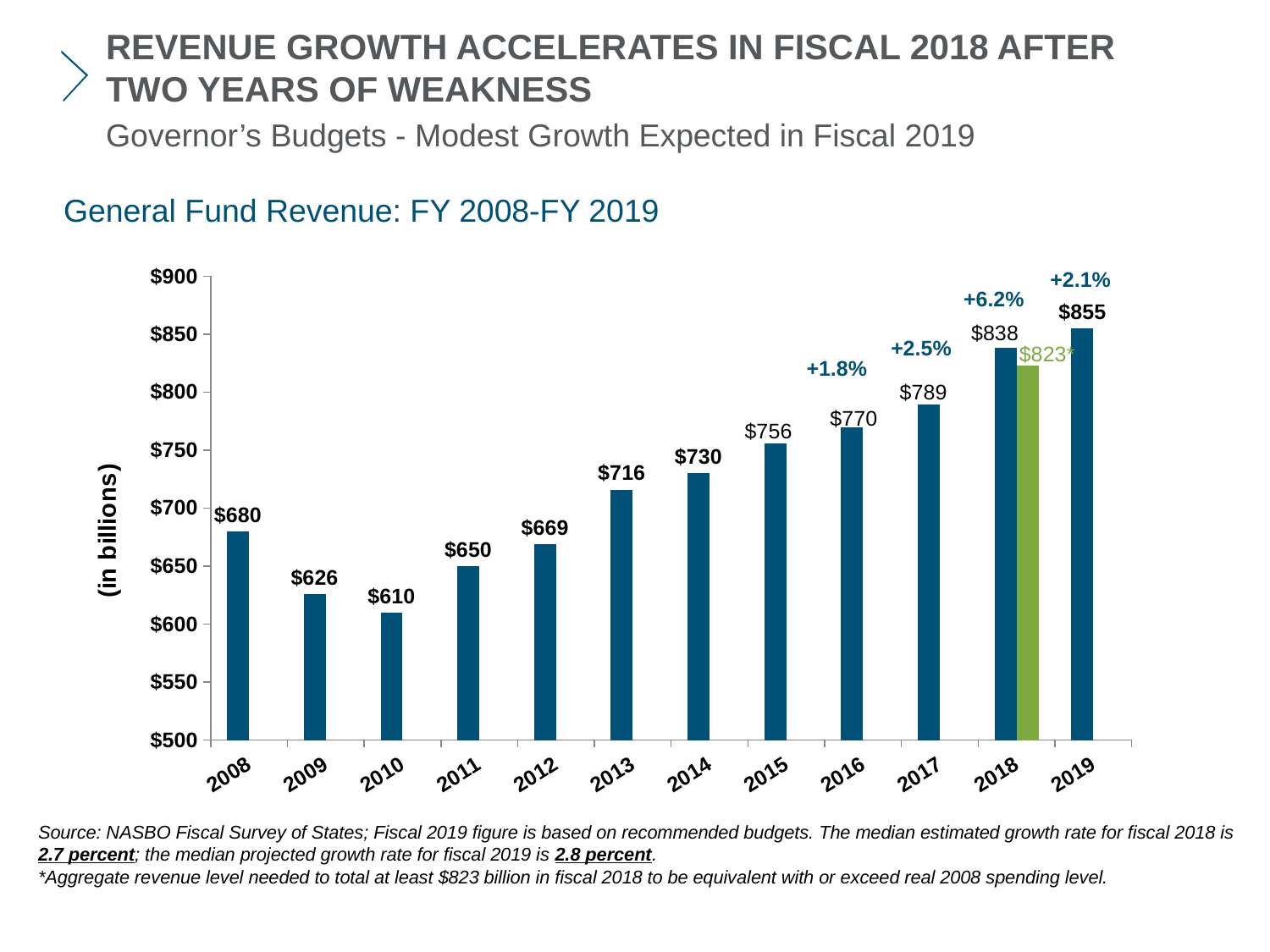
What unit is shown on the y axis label of the chart? in billions What is the General Fund Revenue value for 2013? $716 What kind of chart is used to show General Fund Revenue? Bar chart Do the General Fund Revenue values rise or fall from 2010 to 2019? Rise What is the General Fund Revenue value for 2019? $855 Which year has the lowest General Fund Revenue? 2010 How many fiscal years are shown on the x axis of the chart? 12 Which year has the highest General Fund Revenue? 2019 Which year has a larger General Fund Revenue, 2011 or 2012? 2012 What is the difference between the General Fund Revenue in 2018 and 2017? $49 What growth rate is labeled above the 2018 bar? +6.2% What is the General Fund Revenue value for 2008? $680